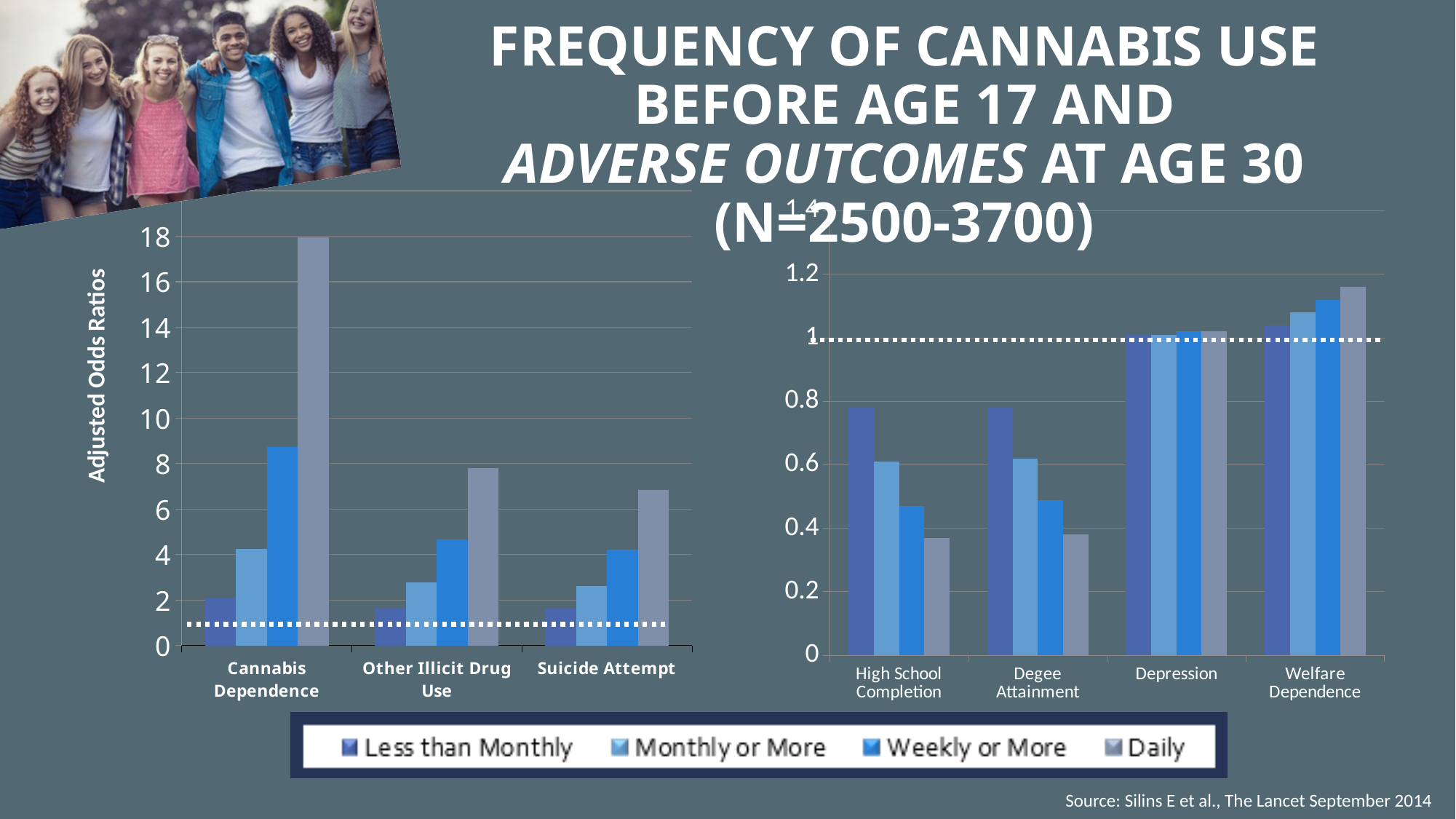
In the right chart, is the Daily value for High School Completion greater or less than 0.4? less In the left chart, is the Daily value for Cannabis Dependence greater or less than 16? greater How many series does the legend list? 4 In the left chart, which category has the highest bar overall? Cannabis Dependence What kind of chart is the left chart on the slide? bar chart How many categories are shown on the x axis of the right chart? 4 In the left chart, is the Daily value for Suicide Attempt greater or less than 6? greater In the left chart, which is larger for Other Illicit Drug Use: the Daily value or the Monthly or More value? Daily How many categories are shown on the x axis of the left chart (Adjusted Odds Ratios)? 3 In the right chart, which series has the lowest value for Degee Attainment? Daily